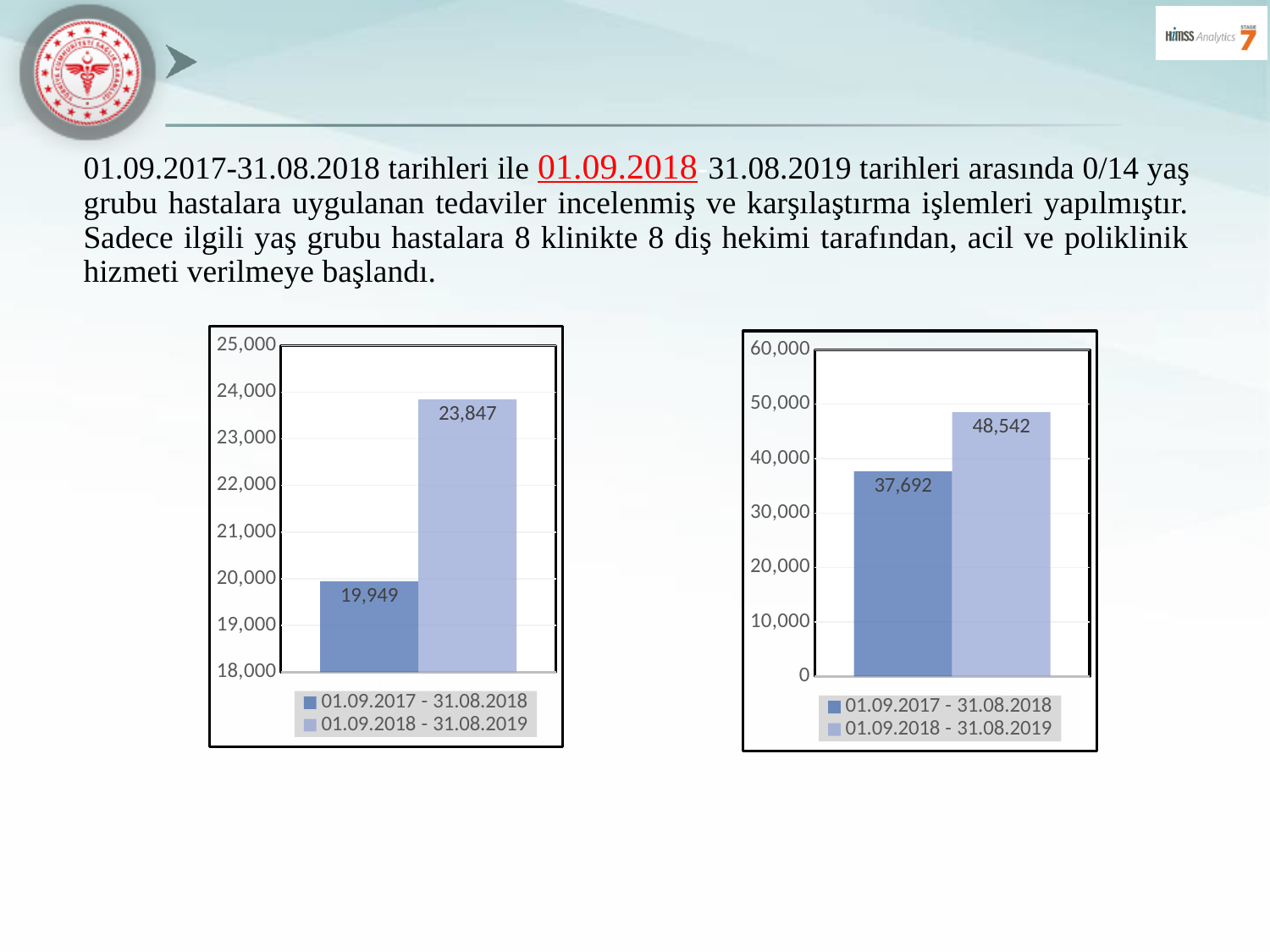
In the left chart, what is the value for 01.09.2018 - 31.08.2019? 23,847 In the right chart, is the value for 01.09.2017 - 31.08.2018 greater or less than 40,000? less In the left chart, is the value for 01.09.2018 - 31.08.2019 greater or less than 23,000? greater In the right chart, what is the value for 01.09.2018 - 31.08.2019? 48,542 In the left chart, which period has the higher value? 01.09.2018 - 31.08.2019 How many series does the legend of the right chart list? 2 In the left chart, what is the value for 01.09.2017 - 31.08.2018? 19,949 In the right chart, which period has the lower value? 01.09.2017 - 31.08.2018 In the right chart, what is the difference between the 01.09.2018 - 31.08.2019 value and the 01.09.2017 - 31.08.2018 value? 10,850 What kind of chart is the left chart? bar chart In the left chart, what is the difference between the 01.09.2018 - 31.08.2019 value and the 01.09.2017 - 31.08.2018 value? 3,898 In the right chart, what is the value for 01.09.2017 - 31.08.2018? 37,692